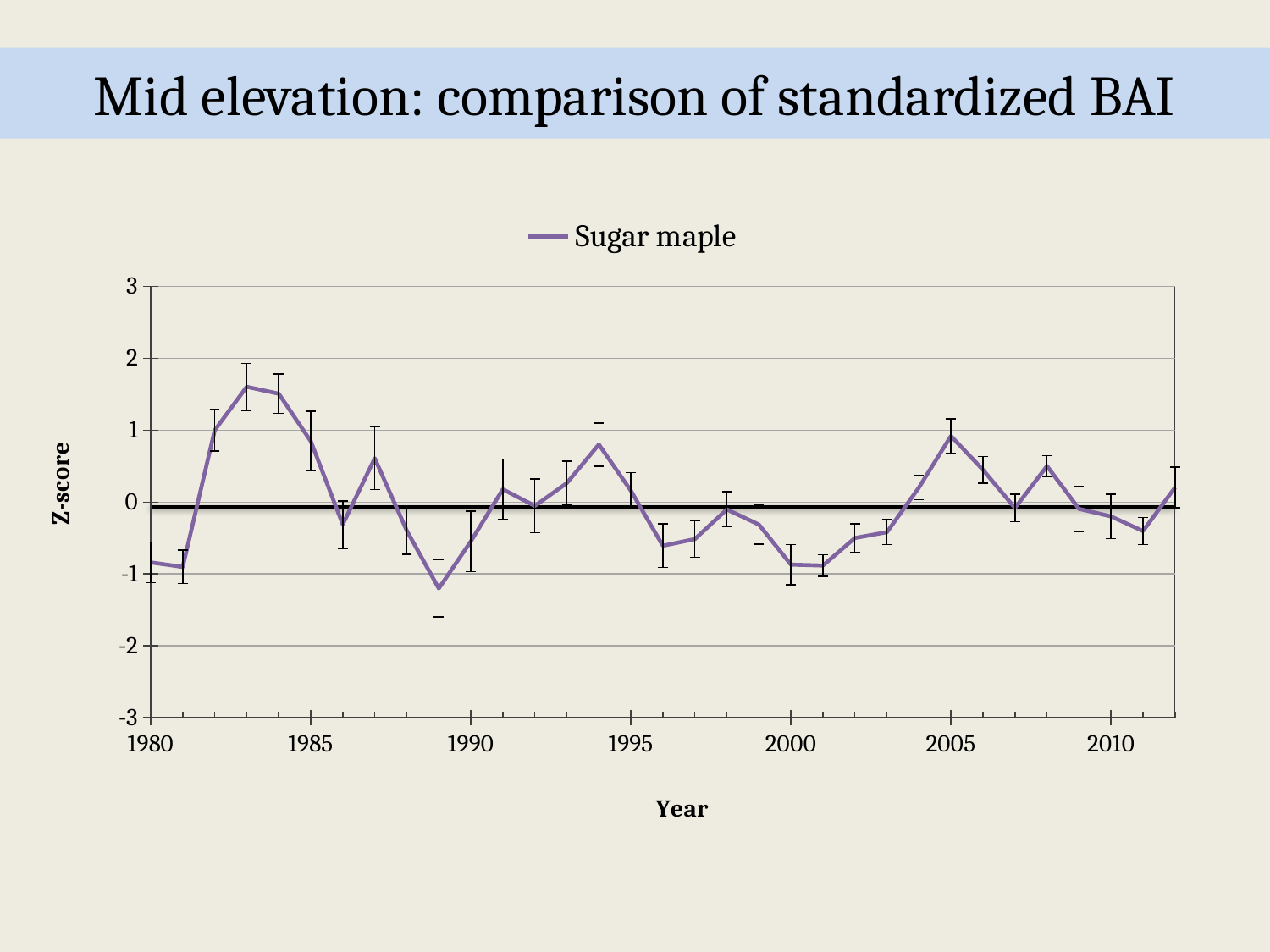
What is the label on the vertical axis? Z-score Is the Sugar maple Z-score for 2005 greater or less than 0? greater Between 1984 and 1989, does the Sugar maple Z-score generally rise or fall? fall Which year has the larger Sugar maple Z-score, 1983 or 1989? 1983 What kind of chart is shown on the slide? Line chart What is the name of the series shown in the legend? Sugar maple How many series does the legend list? 1 In which year is the Sugar maple Z-score lowest? 1989 Is the Sugar maple Z-score for 1983 greater or less than 1? greater Which year has the larger Sugar maple Z-score, 2001 or 2005? 2005 Is the Sugar maple Z-score for 1989 greater or less than -1? less